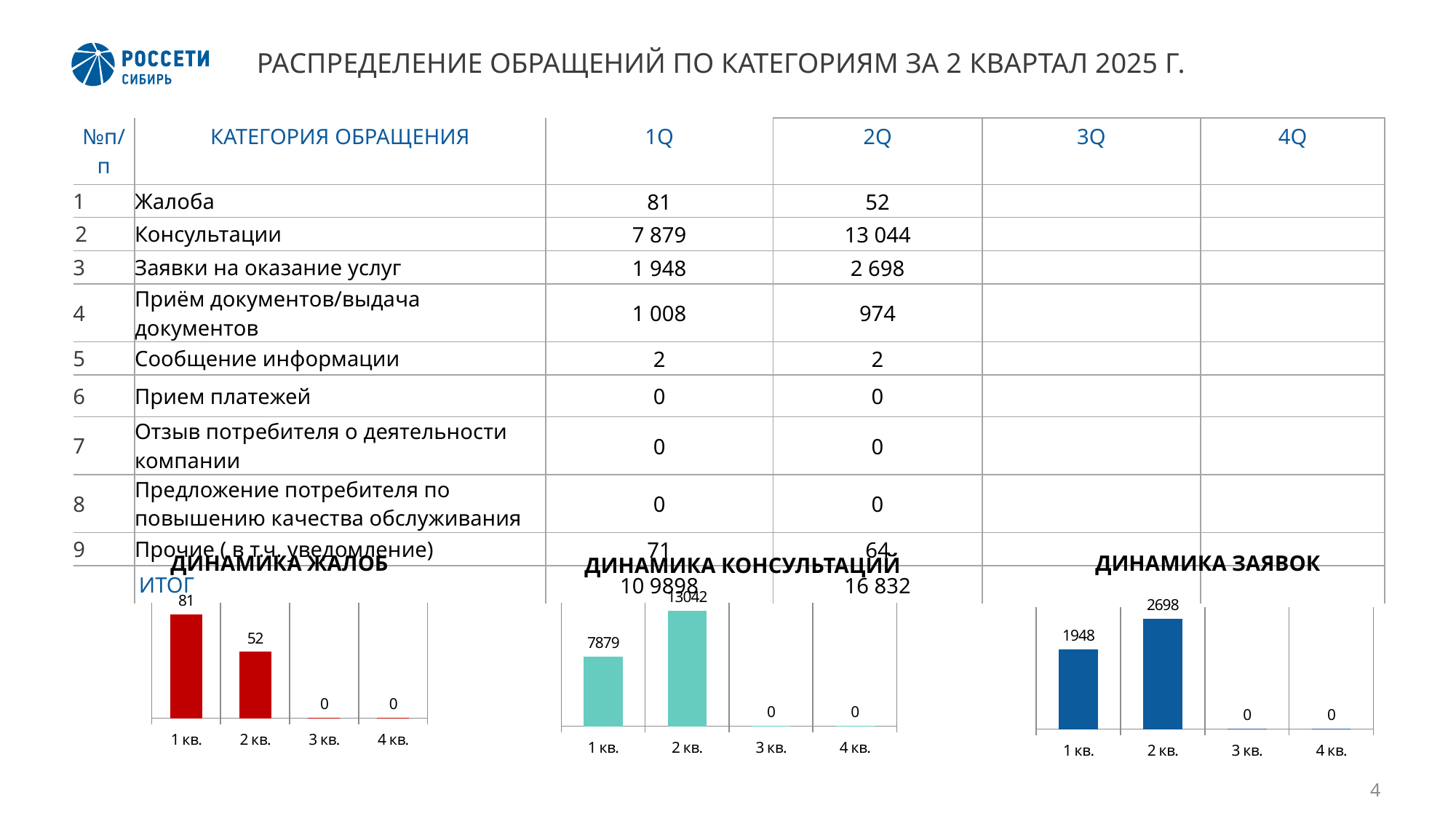
In the chart titled ДИНАМИКА ЖАЛОБ, what is the value for 1 кв.? 81 In the chart titled ДИНАМИКА ЗАЯВОК, which is larger, the value for 1 кв. or 2 кв.? 2 кв. How many categories are shown on the x axis of the chart titled ДИНАМИКА ЖАЛОБ? 4 In the chart titled ДИНАМИКА ЖАЛОБ, what is the value for 2 кв.? 52 In the chart titled ДИНАМИКА ЖАЛОБ, does the value rise or fall from 1 кв. to 2 кв.? fall In the chart titled ДИНАМИКА КОНСУЛЬТАЦИЙ, what is the value for 2 кв.? 13042 In the chart titled ДИНАМИКА КОНСУЛЬТАЦИЙ, which quarter has the highest value? 2 кв. In the chart titled ДИНАМИКА КОНСУЛЬТАЦИЙ, what is the difference between the values for 2 кв. and 1 кв.? 5163 What kind of chart is the chart titled ДИНАМИКА ЗАЯВОК? bar chart In the chart titled ДИНАМИКА ЗАЯВОК, what is the difference between the values for 2 кв. and 1 кв.? 750 In the chart titled ДИНАМИКА ЖАЛОБ, what is the difference between the values for 1 кв. and 2 кв.? 29 In the chart titled ДИНАМИКА ЗАЯВОК, what is the value for 1 кв.? 1948